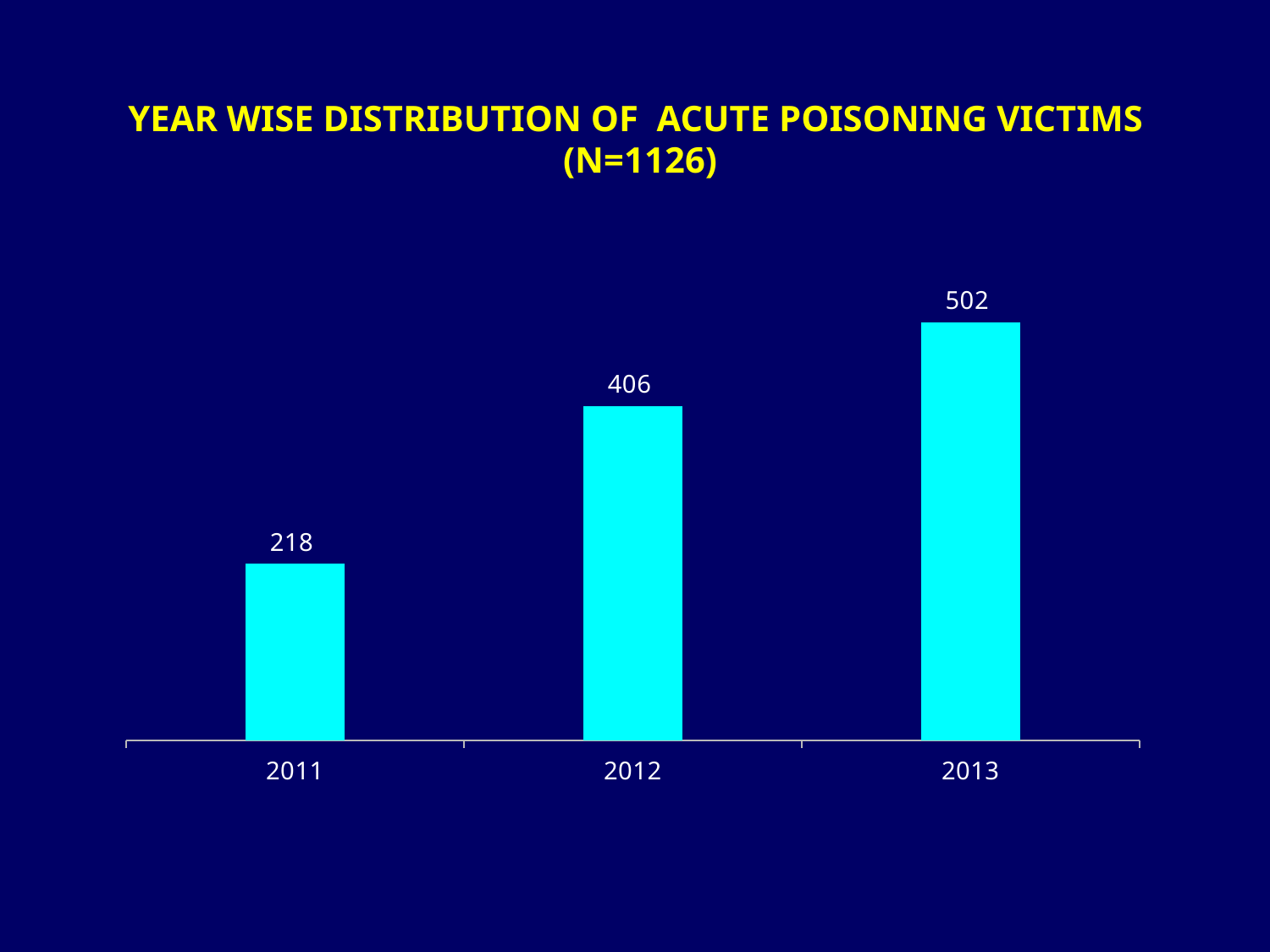
What is the number of acute poisoning victims in 2013? 502 Which year has more acute poisoning victims, 2012 or 2013? 2013 Which year has the highest number of acute poisoning victims? 2013 Do the number of acute poisoning victims rise or fall from 2011 to 2013? Rise What is the total N stated in the chart title? 1126 What is the number of acute poisoning victims in 2012? 406 What kind of chart is shown on the slide? Bar chart What is the number of acute poisoning victims in 2011? 218 How many years are shown on the chart? 3 Which year has the lowest number of acute poisoning victims? 2011 What is the difference between the number of victims in 2013 and 2011? 284 What is the difference between the number of victims in 2012 and 2011? 188